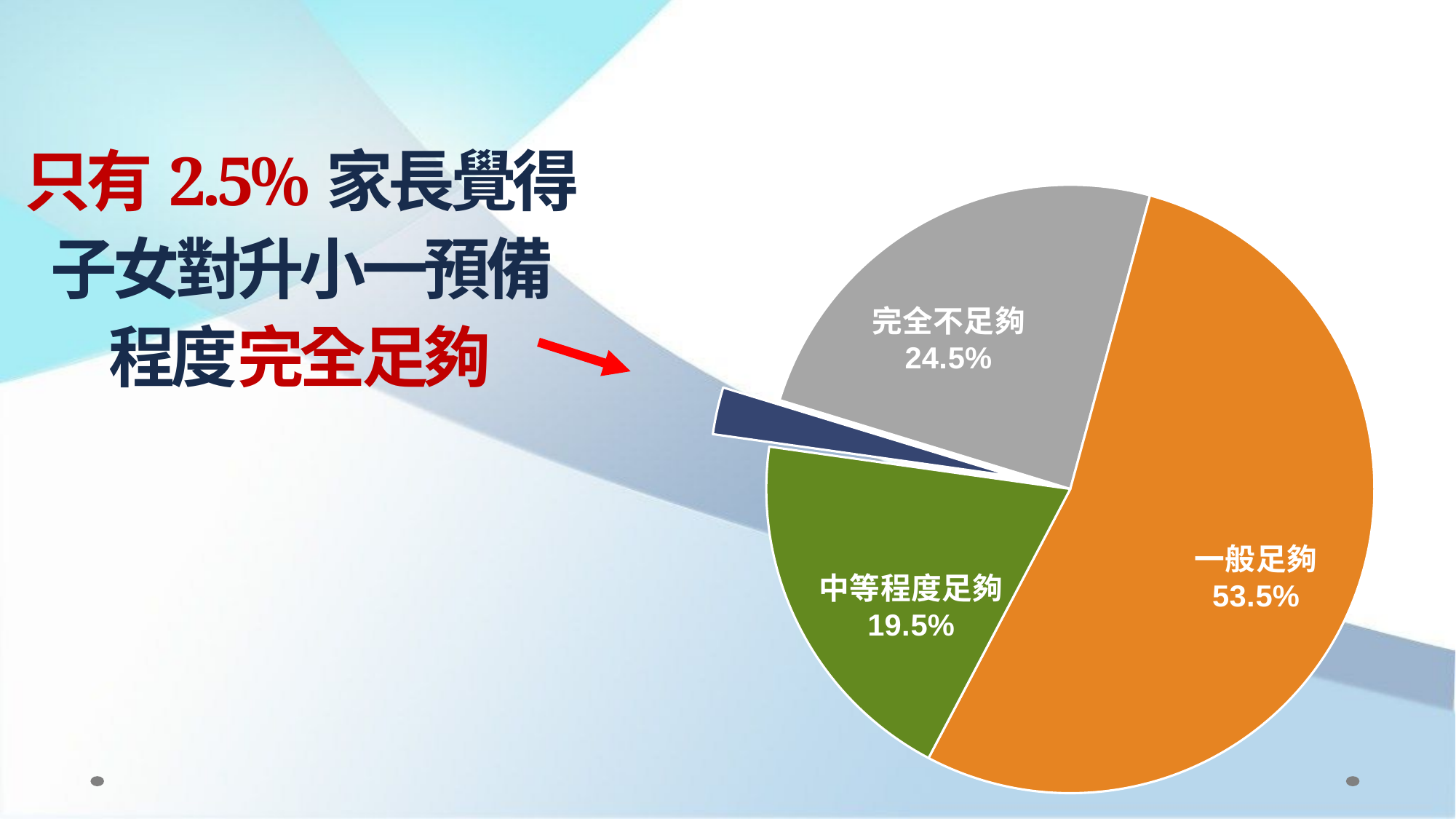
Which slice is pulled out (exploded) from the pie? 完全足夠 What percentage of the pie is labelled 中等程度足夠? 19.5% Which category has the largest slice of the pie? 一般足夠 What percentage of the pie is labelled 一般足夠? 53.5% Which category has the smallest slice of the pie? 完全足夠 According to the slide text, what percentage of parents feel their child's preparation is 完全足夠? 2.5% What colour is the slice for 一般足夠? orange What kind of chart is shown on the slide? pie chart Which is larger, the slice for 完全不足夠 or the slice for 中等程度足夠? 完全不足夠 What is the difference in percentage points between 一般足夠 and 完全不足夠? 29 How many slices does the pie chart have? 4 What percentage of the pie is labelled 完全不足夠? 24.5%